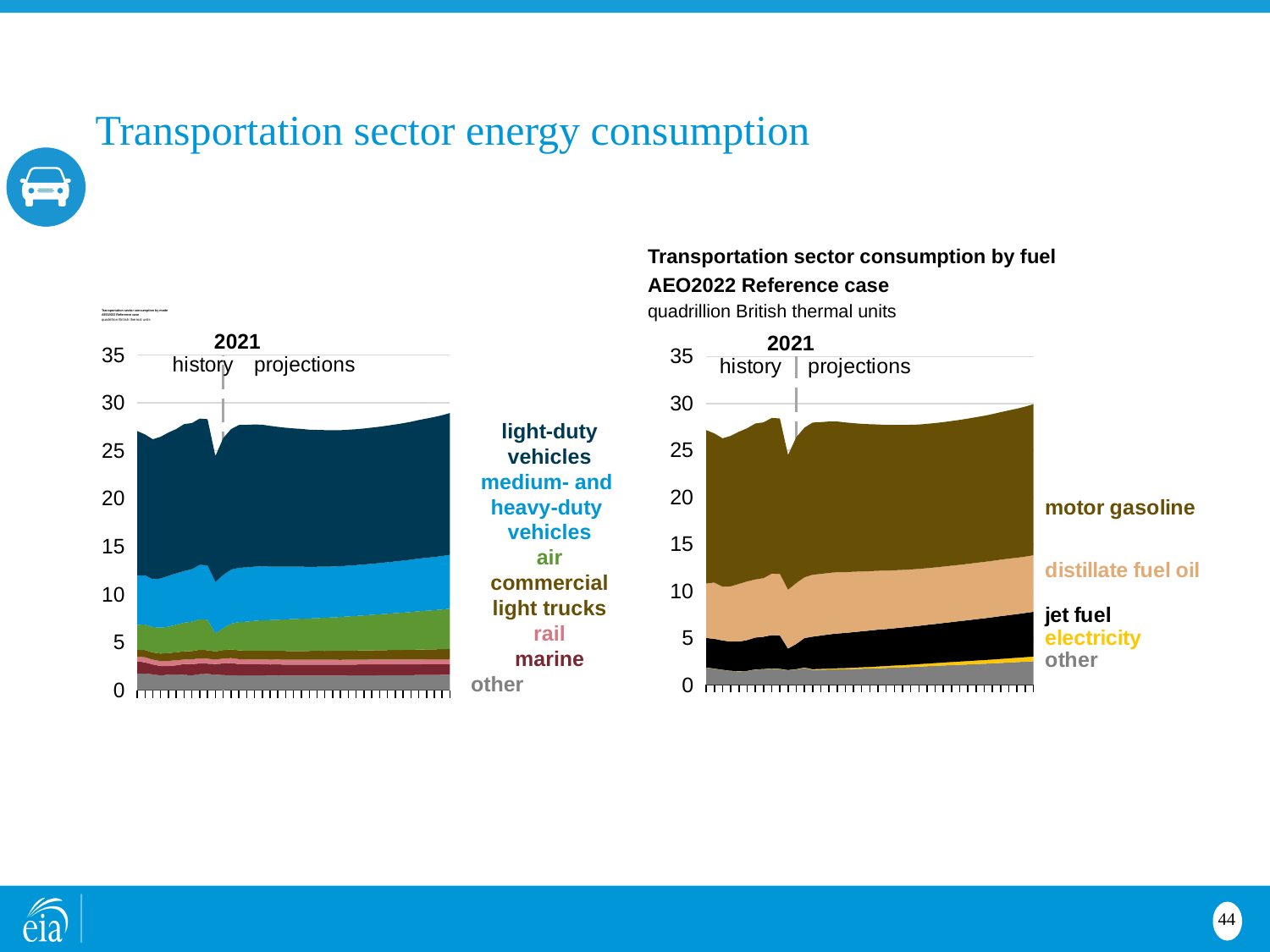
How many series are labelled on the left-hand chart? 7 In the right-hand chart, 'Transportation sector consumption by fuel', is the total consumption at the end of the projection period greater or less than 20? greater In the right-hand chart, 'Transportation sector consumption by fuel', is consumption of motor gasoline larger or smaller than consumption of electricity? larger In the right-hand chart, 'Transportation sector consumption by fuel', which year separates history from projections? 2021 In the left-hand chart, is consumption by light-duty vehicles larger or smaller than consumption by rail? larger What kind of chart is the right-hand chart, 'Transportation sector consumption by fuel'? stacked area chart In the right-hand chart, 'Transportation sector consumption by fuel', which fuel accounts for the largest share of consumption? motor gasoline In the right-hand chart, 'Transportation sector consumption by fuel', is the total consumption at the start of the history period greater or less than 25? greater In the left-hand chart, which mode accounts for the largest share of transportation energy consumption? light-duty vehicles How many series are labelled on the right-hand chart, 'Transportation sector consumption by fuel'? 5 What kind of chart is the left-hand chart on the slide? stacked area chart What unit of measurement is used on the right-hand chart, 'Transportation sector consumption by fuel'? quadrillion British thermal units